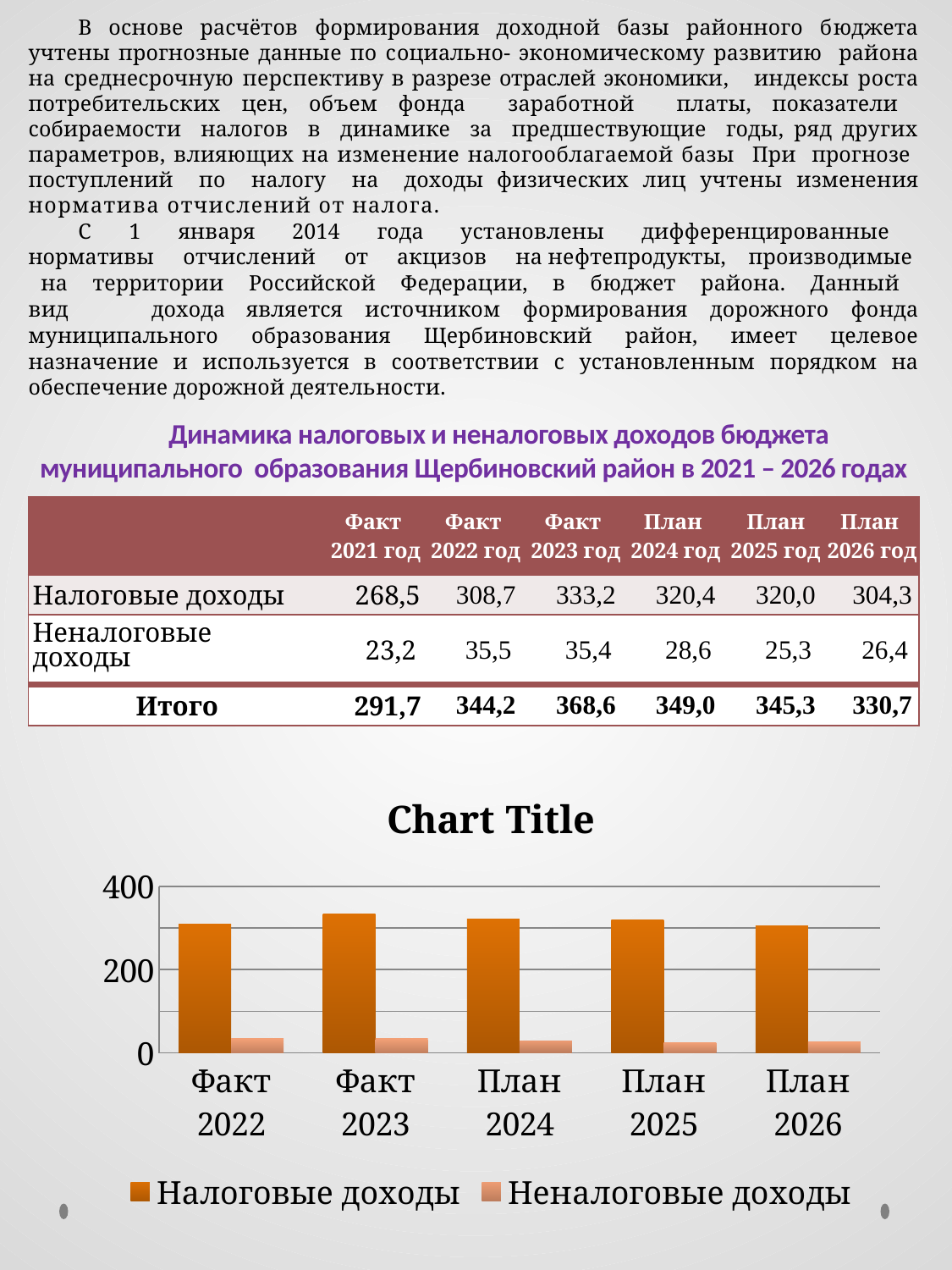
How many categories are shown along the x axis of the chart? 5 Which series is shown in the lighter (salmon) colour in the chart? Неналоговые доходы Is the value for Налоговые доходы in План 2024 greater or less than 200? greater Do the bars for Налоговые доходы rise or fall from Факт 2023 to План 2026? fall Is the value for Неналоговые доходы in Факт 2022 greater or less than 200? less What kind of chart is shown on the slide? bar chart What is the title printed above the chart? Chart Title How many series does the chart legend list? 2 Which is larger for Налоговые доходы: Факт 2023 or План 2026? Факт 2023 In which category is the bar for Налоговые доходы the tallest? Факт 2023 According to the table on the slide, what is the value of Налоговые доходы for Факт 2023 год? 333,2 Which is larger in План 2026: Налоговые доходы or Неналоговые доходы? Налоговые доходы